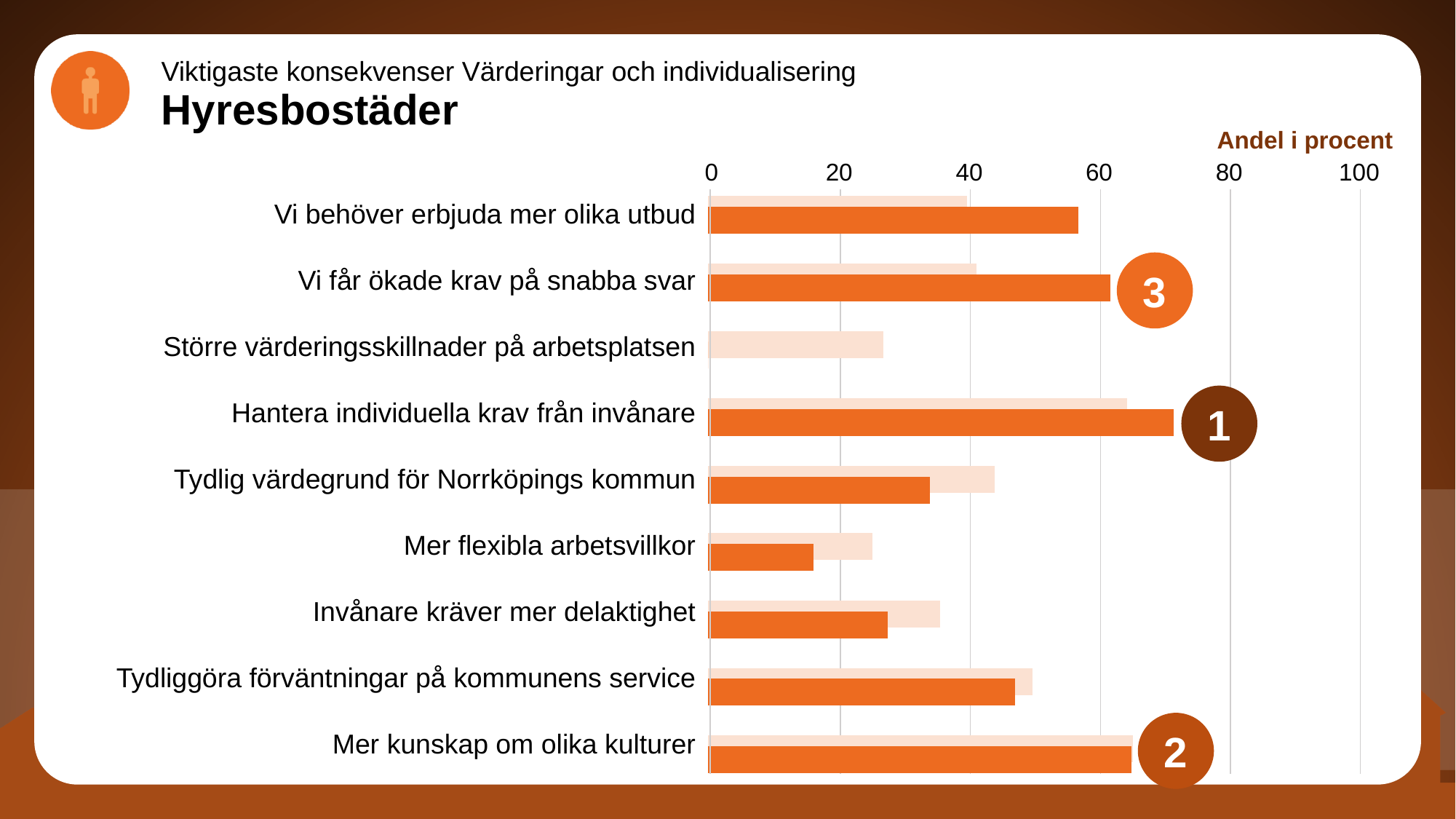
How many categories are listed on the chart? 9 Is the dark orange bar for 'Tydliggöra förväntningar på kommunens service' greater or less than 40? greater Which has the longer dark orange bar: 'Invånare kräver mer delaktighet' or 'Vi får ökade krav på snabba svar'? Vi får ökade krav på snabba svar What kind of chart is shown on the slide? Bar chart Is the dark orange bar for 'Mer flexibla arbetsvillkor' greater or less than 20? less Which has the longer dark orange bar: 'Vi behöver erbjuda mer olika utbud' or 'Tydlig värdegrund för Norrköpings kommun'? Vi behöver erbjuda mer olika utbud Is the dark orange bar for 'Mer kunskap om olika kulturer' greater or less than 60? greater What is the label shown above the horizontal axis of the chart? Andel i procent Which category has the longest dark orange bar? Hantera individuella krav från invånare Which category is marked with the circled number 1? Hantera individuella krav från invånare